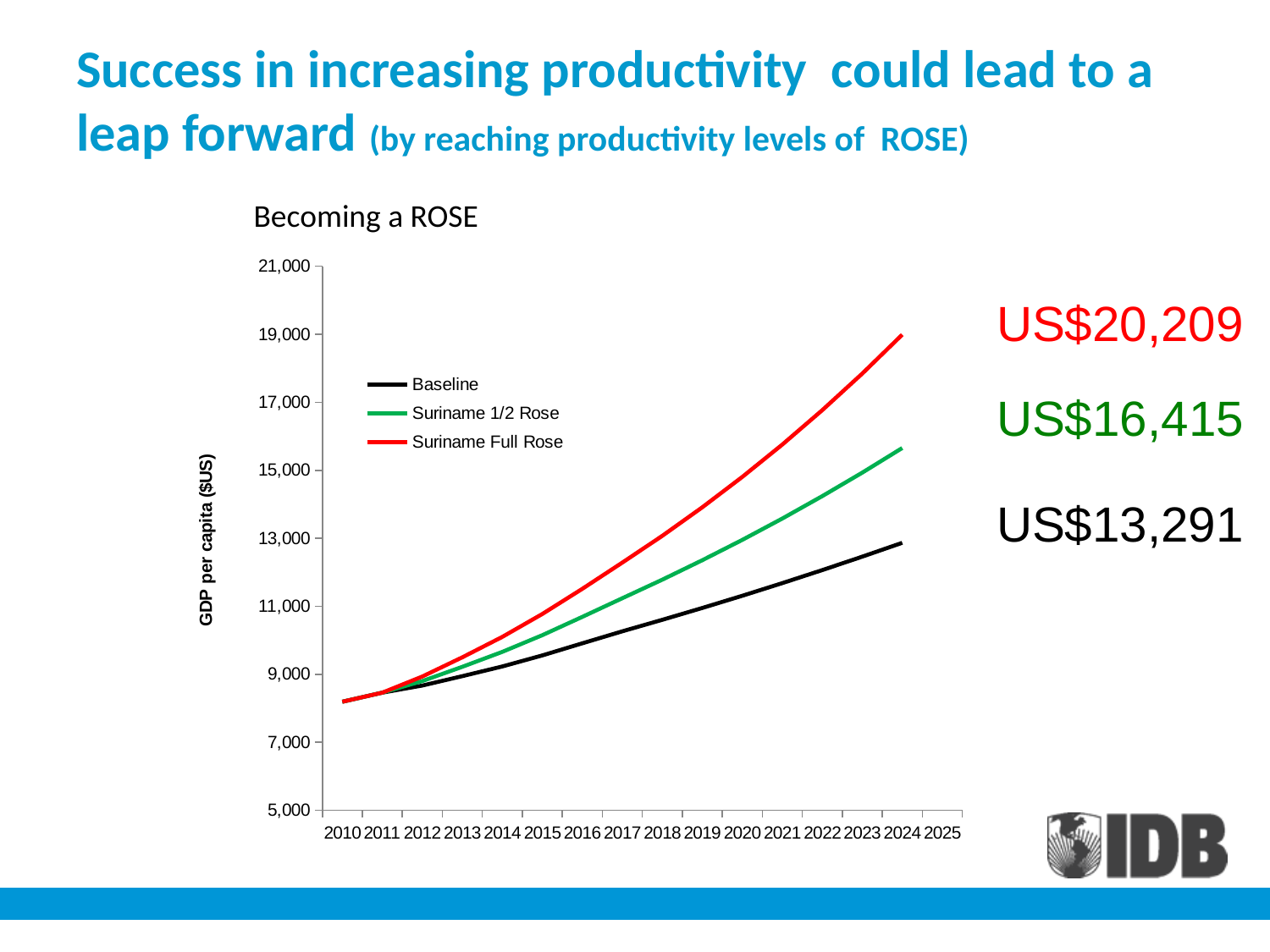
What kind of chart is shown on the slide? Line chart Which series reaches the highest GDP per capita by the end of the chart? Suriname Full Rose Do the GDP per capita values rise or fall from 2010 to the end of the chart? Rise What is the difference between the green-text value (US$16,415) and the black-text value (US$13,291) shown beside the chart? US$3,124 What is the difference between the red-text value (US$20,209) and the black-text value (US$13,291) shown beside the chart? US$6,918 Which series has the lowest GDP per capita at the end of the chart? Baseline Which is larger at the end of the chart, Suriname 1/2 Rose or Baseline? Suriname 1/2 Rose How many series does the legend of the "Becoming a ROSE" chart list? 3 What is the label of the y axis of the chart? GDP per capita ($US) Is the Suriname Full Rose value in 2024 greater or less than 17,000? greater Is the Baseline value in 2010 greater or less than 9,000? less